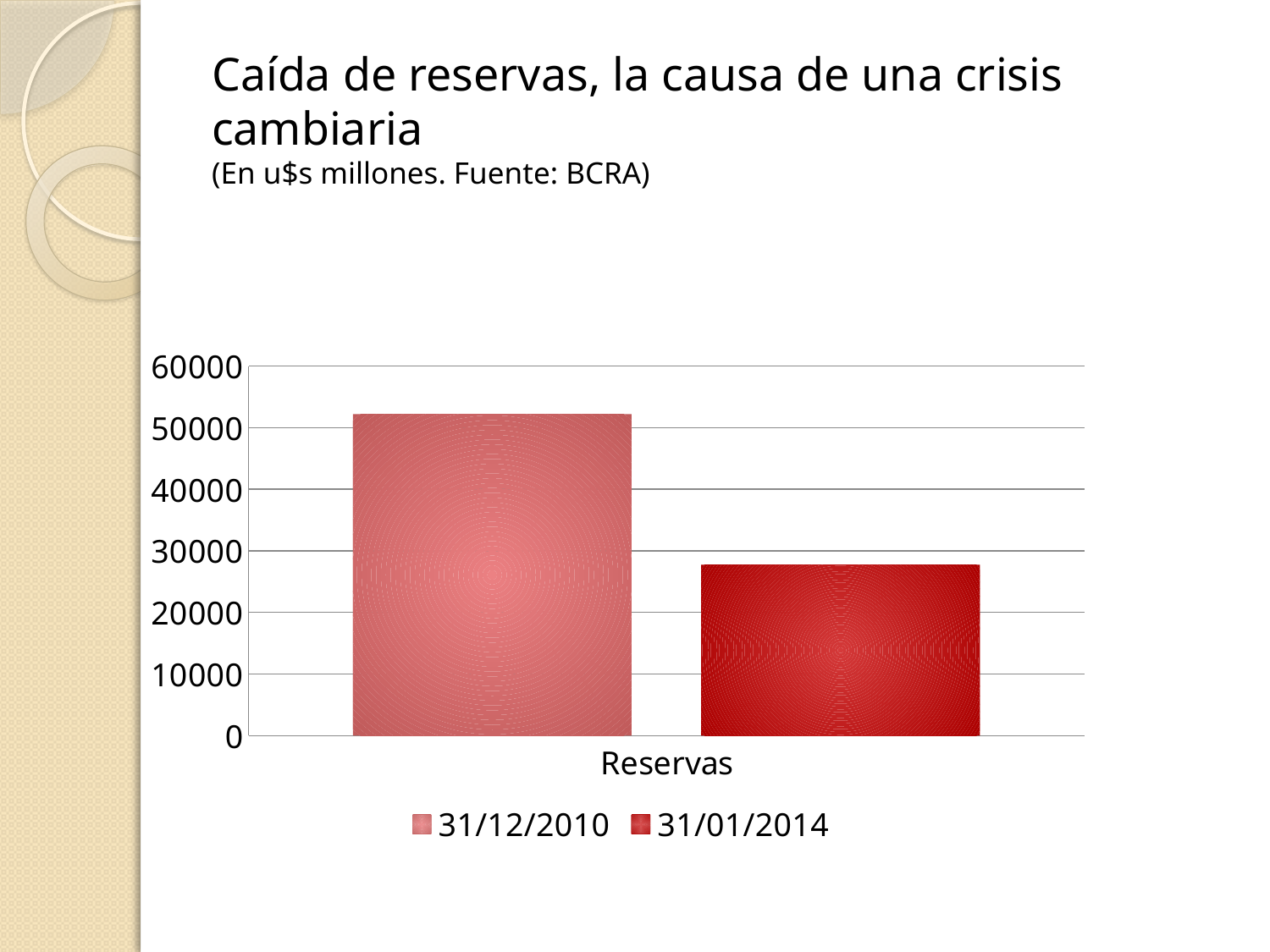
Is the value for 31/12/2010 greater or less than 50000? greater What kind of chart is shown on the slide? bar chart Is the value for 31/12/2010 greater or less than 60000? less Is the value for 31/01/2014 greater or less than 30000? less How many series does the legend list? 2 Which series shows the lowest value for Reservas? 31/01/2014 What source is cited for the chart data? BCRA Which series shows the highest value for Reservas? 31/12/2010 Which series has the higher value for Reservas, 31/12/2010 or 31/01/2014? 31/12/2010 How many categories are shown on the x axis? 1 What is the label of the category on the x axis? Reservas